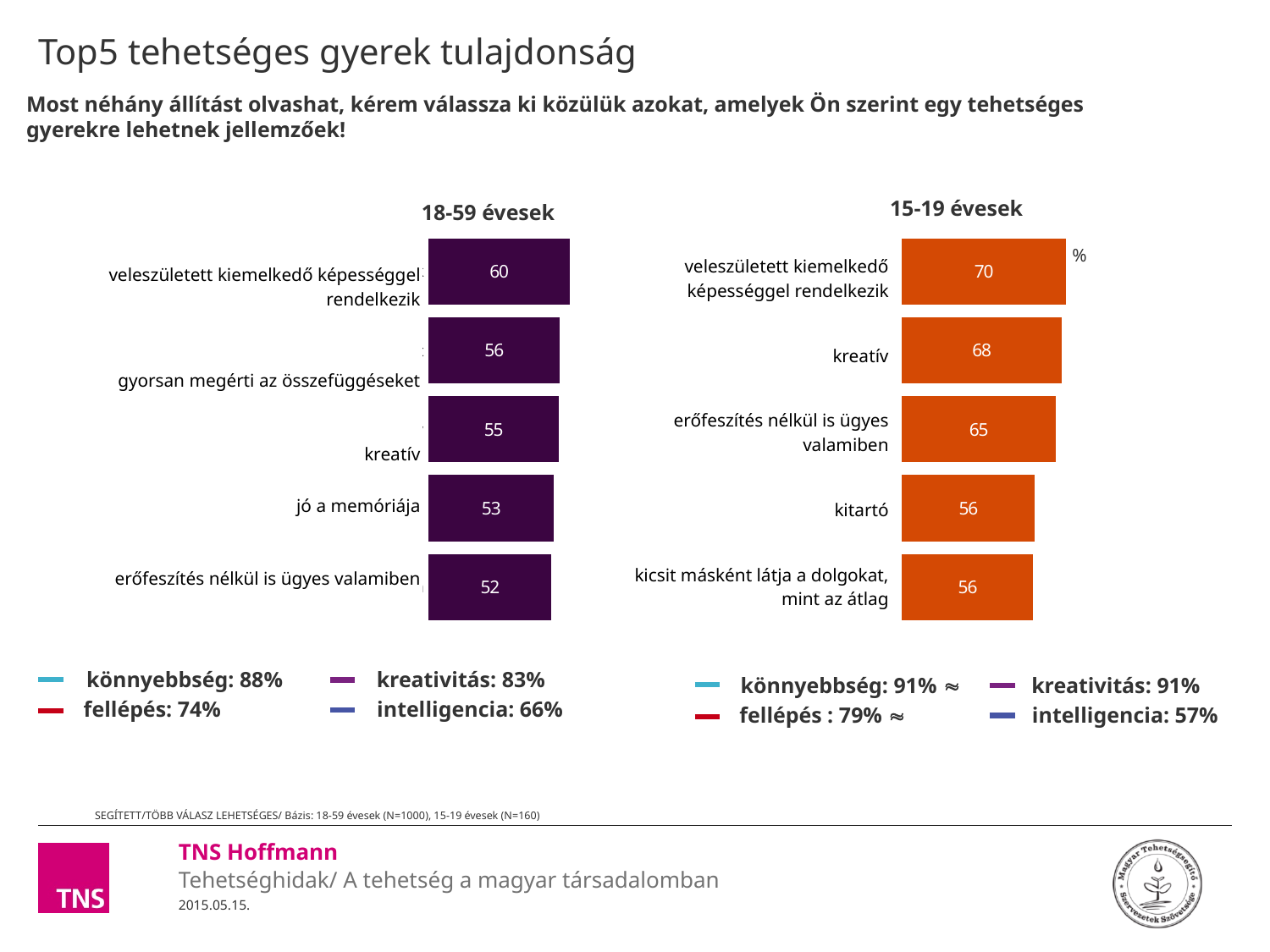
In the '15-19 évesek' chart, what is the value for 'erőfeszítés nélkül is ügyes valamiben'? 65 How many categories are shown in the '15-19 évesek' chart? 5 What kind of chart is the '18-59 évesek' chart? bar chart What colour are the bars in the '15-19 évesek' chart? orange Which is larger: the value for 'kreatív' in the '18-59 évesek' chart or the value for 'kreatív' in the '15-19 évesek' chart? 15-19 évesek In the '15-19 évesek' chart, what is the value for 'kicsit másként látja a dolgokat, mint az átlag'? 56 In the '18-59 évesek' chart, which category has the lowest value? erőfeszítés nélkül is ügyes valamiben In the '18-59 évesek' chart, which category has the highest value? veleszületett kiemelkedő képességgel rendelkezik In the '18-59 évesek' chart, what is the difference between the values for 'gyorsan megérti az összefüggéseket' and 'jó a memóriája'? 3 In the '15-19 évesek' chart, which category has the highest value? veleszületett kiemelkedő képességgel rendelkezik In the '15-19 évesek' chart, what is the difference between the values for 'veleszületett kiemelkedő képességgel rendelkezik' and 'kitartó'? 14 In the '18-59 évesek' chart, what is the value for 'kreatív'? 55